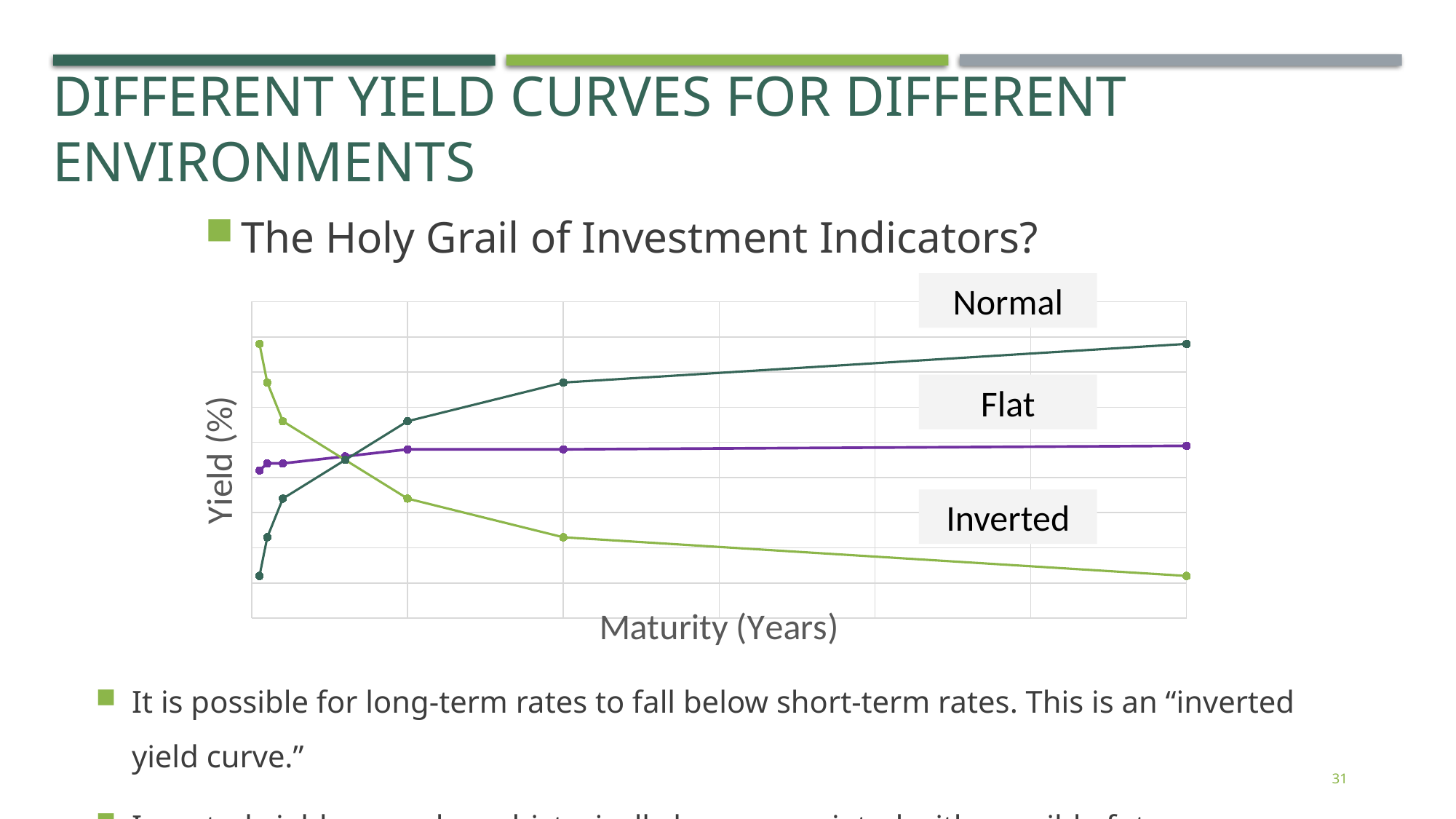
Does the Inverted yield curve rise or fall as maturity increases? falls At the longest maturity shown, which curve has the higher yield, Normal or Inverted? Normal At the shortest maturity shown, which curve has the higher yield, Normal or Inverted? Inverted Which curve has the lowest yield at the shortest maturity shown? Normal What is the title of the horizontal axis of the chart? Maturity (Years) How many yield curves (series) are plotted on the chart? 3 Which curve has the highest yield at the longest maturity shown? Normal What kind of chart is shown on the slide? line chart Does the Flat yield curve change much as maturity increases? no, it stays roughly flat What is the title of the vertical axis of the chart? Yield (%) Does the Normal yield curve rise or fall as maturity increases? rises How many data points are marked on the Normal yield curve? 7